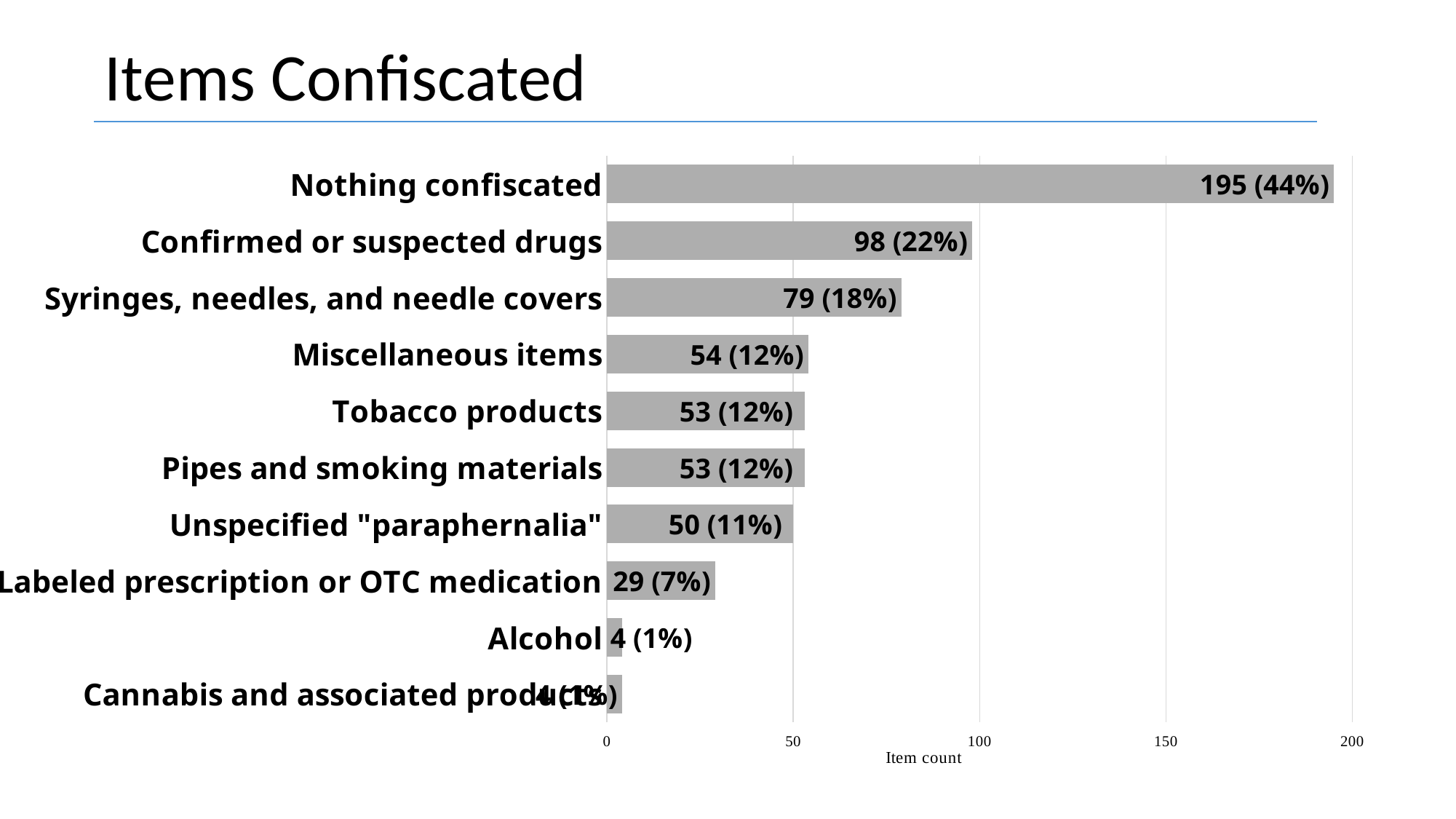
What is the difference in item count between Nothing confiscated and Confirmed or suspected drugs? 97 Which category has the highest item count? Nothing confiscated What is the item count for Alcohol? 4 (1%) Which has a larger item count, Unspecified "paraphernalia" or Labeled prescription or OTC medication? Unspecified "paraphernalia" What kind of chart is shown on the slide? Bar chart What is the label on the horizontal axis of the chart? Item count What is the item count for Labeled prescription or OTC medication? 29 (7%) What is the item count for Nothing confiscated? 195 (44%) How many categories are shown in the chart? 10 What is the item count for Confirmed or suspected drugs? 98 (22%) What is the difference in item count between Syringes, needles, and needle covers and Miscellaneous items? 25 What is the item count for Syringes, needles, and needle covers? 79 (18%)